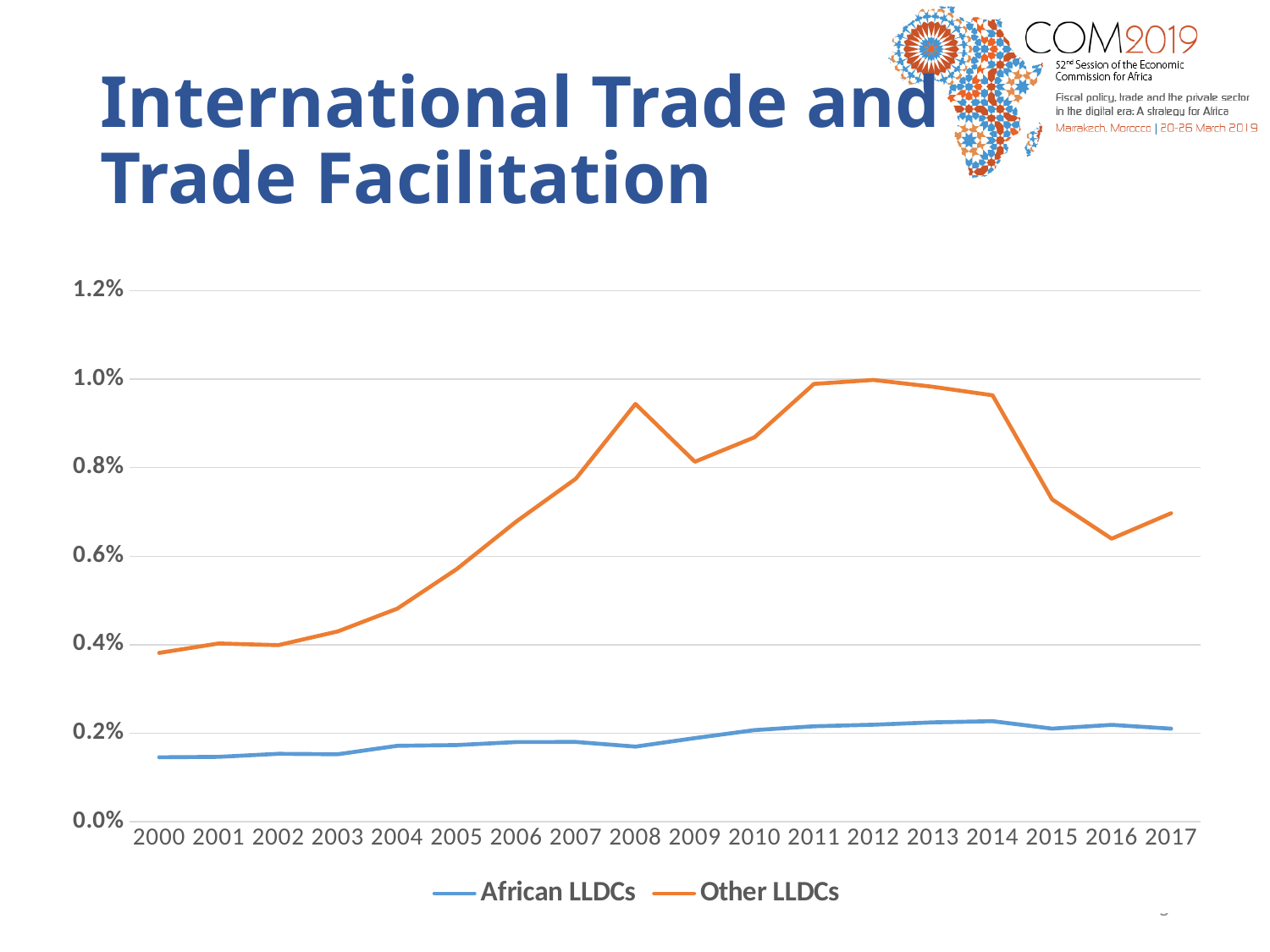
What colour is the line for Other LLDCs? orange Is the value for Other LLDCs in 2016 greater or less than 0.8%? less Is the value for African LLDCs in 2000 greater or less than 0.2%? less Does the Other LLDCs line rise or fall between 2000 and 2008? rise How many years are plotted along the x axis? 18 How many series does the legend list? 2 Does the Other LLDCs line rise or fall between 2012 and 2016? fall Is the value for Other LLDCs in 2008 greater or less than 0.8%? greater What kind of chart is shown on the slide? line chart For Other LLDCs, which year has the larger value, 2008 or 2009? 2008 Which series has the larger value in 2010, African LLDCs or Other LLDCs? Other LLDCs